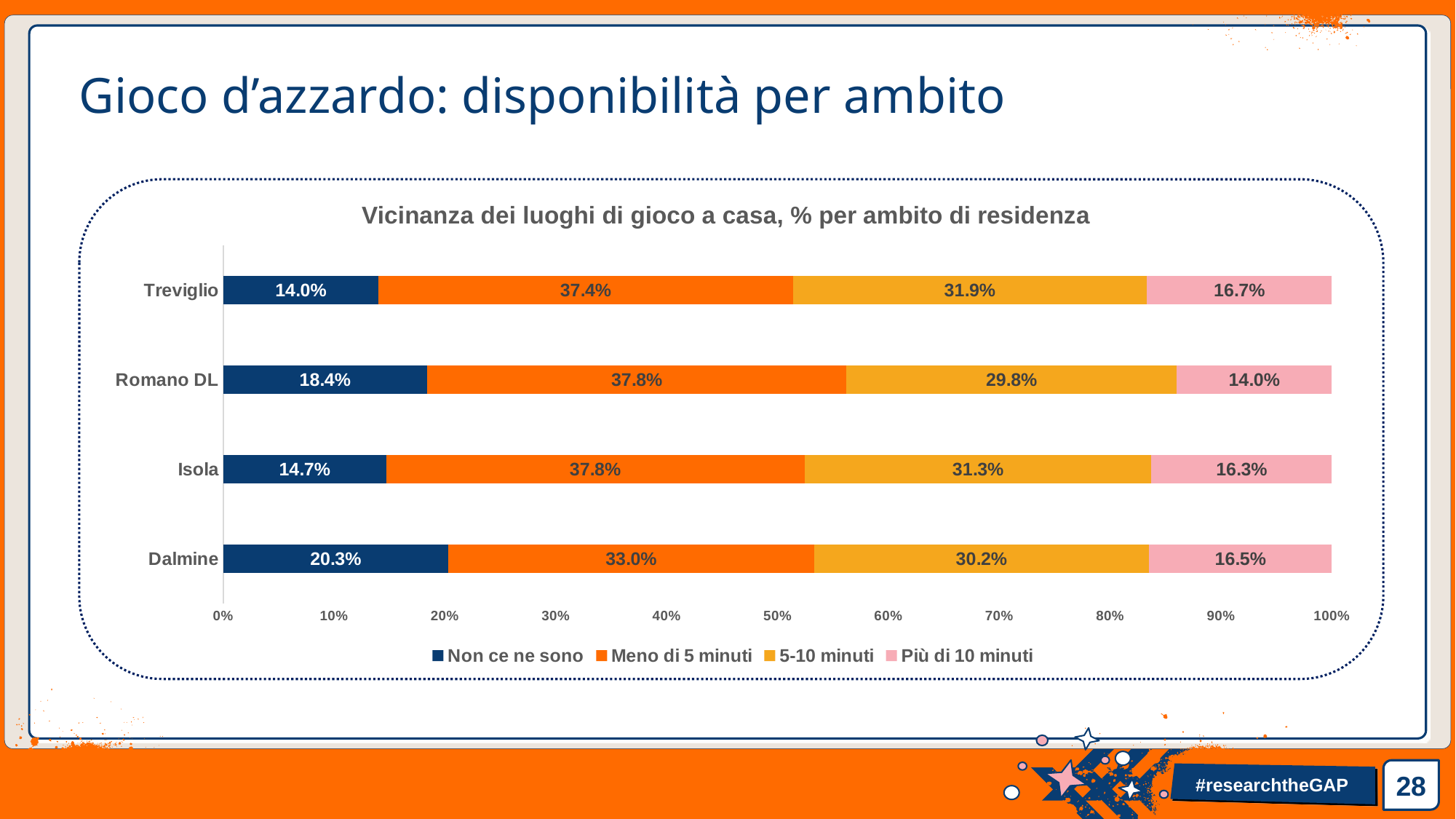
What is the value for "Più di 10 minuti" for Isola? 16.3% What is the value for "Meno di 5 minuti" for Treviglio? 37.4% Which is larger: the "5-10 minuti" value for Treviglio or for Dalmine? Treviglio Which category has the highest value for "Non ce ne sono"? Dalmine What is the value for "Non ce ne sono" for Dalmine? 20.3% Which category has the lowest value for "Più di 10 minuti"? Romano DL What kind of chart is shown on the slide? Stacked bar chart What is the value for "5-10 minuti" for Romano DL? 29.8% How many series does the legend list? 4 How many categories are shown on the y axis? 4 What is the difference between the "Non ce ne sono" values for Dalmine and Treviglio? 6.3% What is the title of the chart? Vicinanza dei luoghi di gioco a casa, % per ambito di residenza